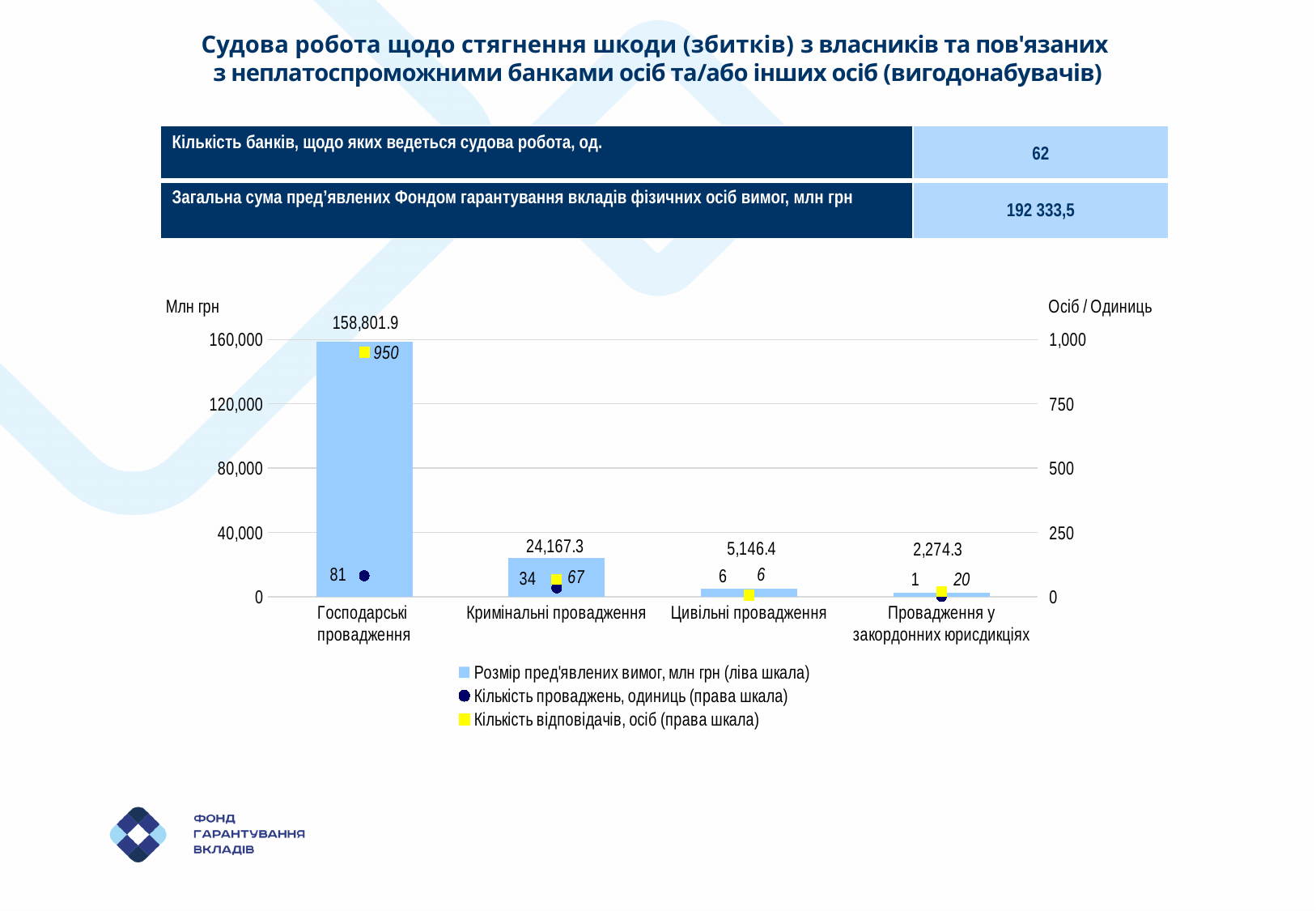
Which is larger: the 'Кількість відповідачів, осіб' for 'Кримінальні провадження' or for 'Провадження у закордонних юрисдикціях'? Кримінальні провадження What is the difference in 'Розмір пред'явлених вимог, млн грн' between 'Цивільні провадження' and 'Провадження у закордонних юрисдикціях'? 2,872.1 What is the 'Кількість відповідачів, осіб' value for 'Провадження у закордонних юрисдикціях'? 20 What is the 'Кількість проваджень, одиниць' value for 'Кримінальні провадження'? 34 What is the value of 'Розмір пред'явлених вимог, млн грн' for 'Господарські провадження'? 158,801.9 How many series does the chart legend list? 3 What is the label of the left vertical axis of the chart? Млн грн How many categories are shown on the x axis of the chart? 4 Which category has the lowest 'Розмір пред'явлених вимог, млн грн'? Провадження у закордонних юрисдикціях What is the value of 'Розмір пред'явлених вимог, млн грн' for 'Кримінальні провадження'? 24,167.3 What is the 'Кількість відповідачів, осіб' value for 'Господарські провадження'? 950 Which category has the highest 'Кількість проваджень, одиниць'? Господарські провадження